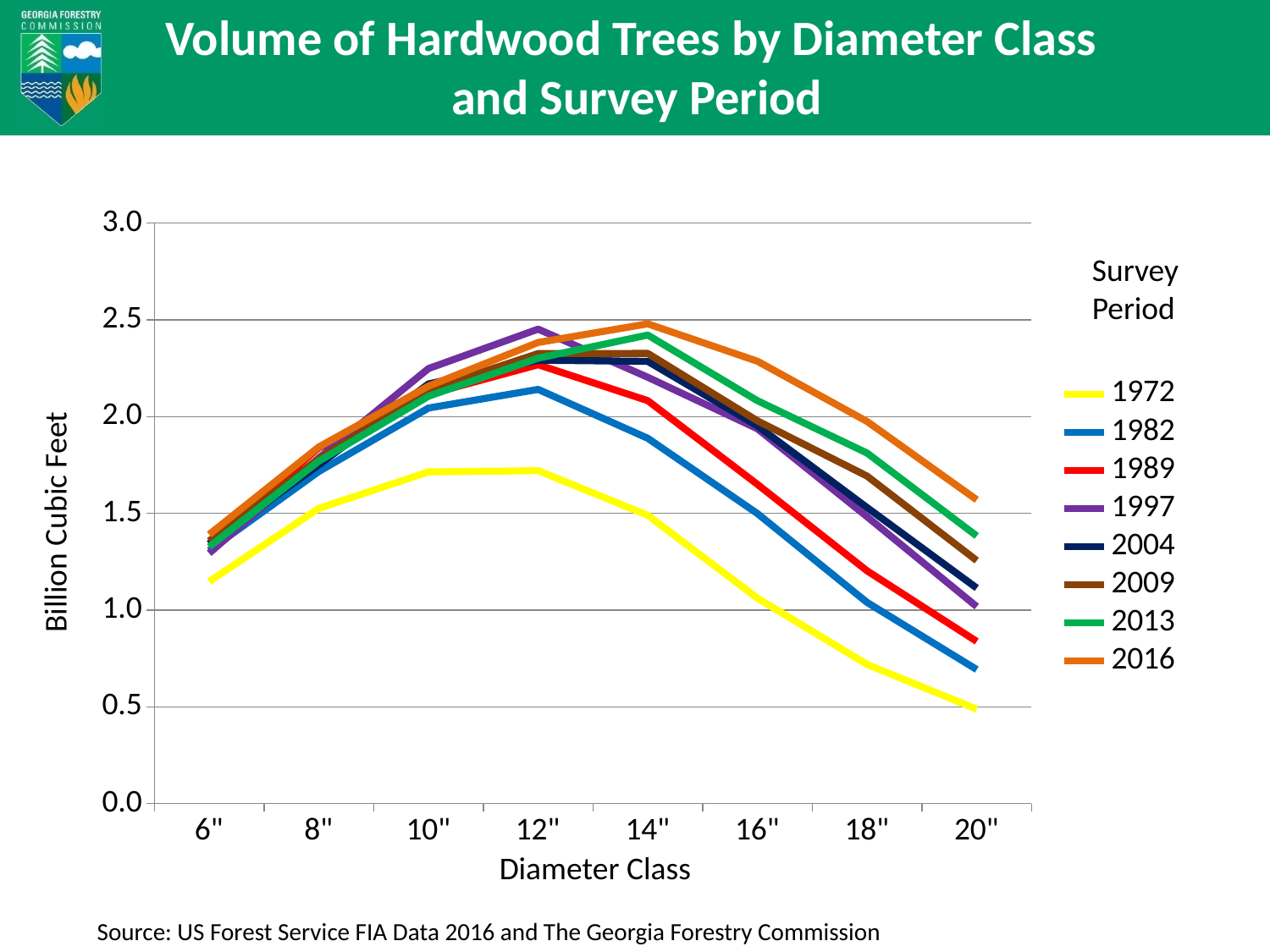
Is the 1972 value at the 12" diameter class greater or less than 1.5? greater How many diameter classes are shown on the x axis? 8 At the 12" diameter class, which is larger: the 1972 value or the 1982 value? 1982 How many survey periods does the legend list? 8 What kind of chart is shown on the slide? line chart Is the 1972 value at the 18" diameter class greater or less than 1.0? less Does the 1972 line rise or fall from the 12" to the 20" diameter class? fall Is the 2016 value at the 20" diameter class greater or less than 1.5? greater Which survey period has the lowest volume at the 16" diameter class? 1972 What is the label on the y axis? Billion Cubic Feet Which survey period has the highest volume at the 18" diameter class? 2016 Which survey period has the highest volume at the 20" diameter class? 2016